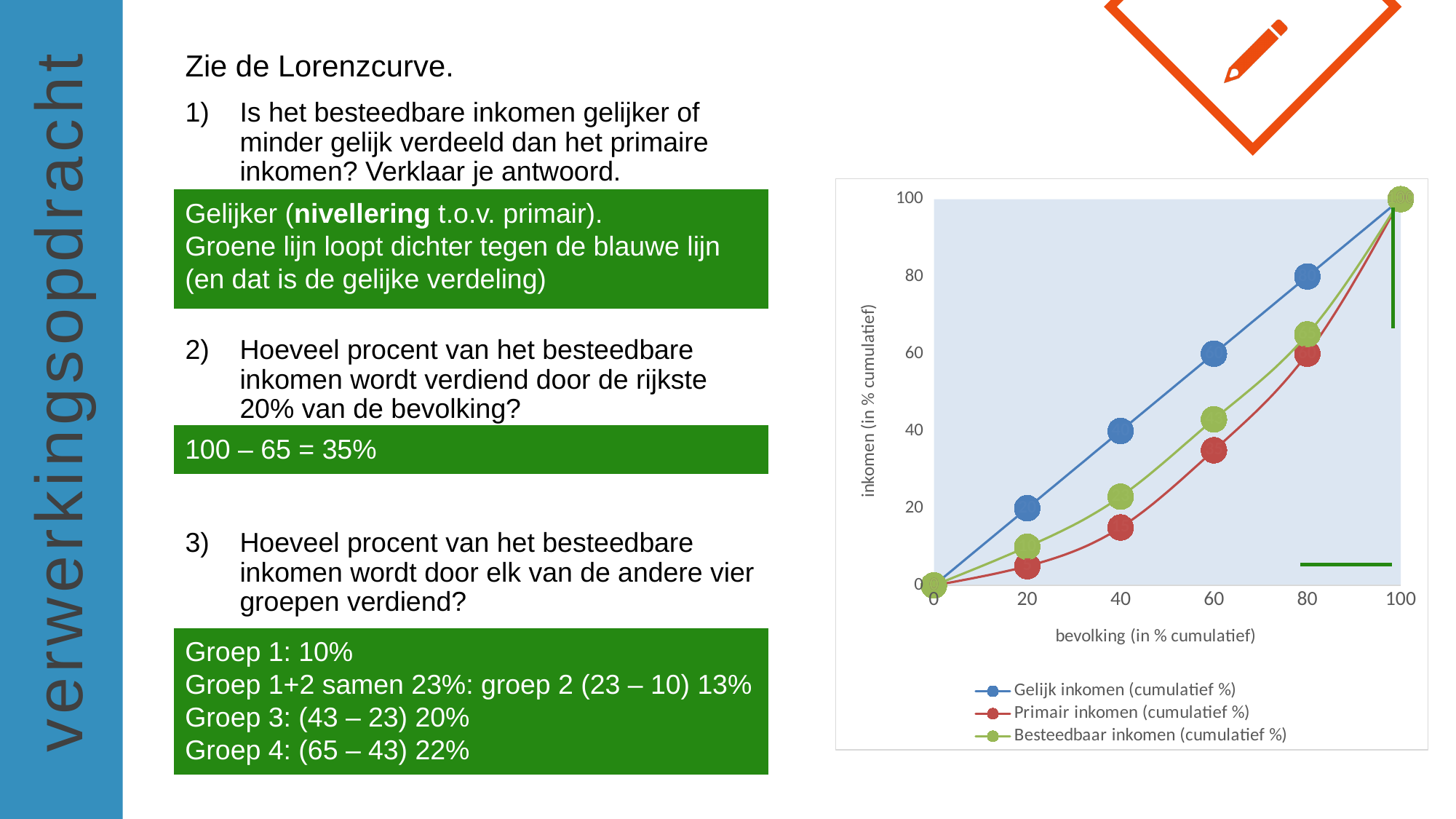
How many series does the chart legend list? 3 Is the value for Besteedbaar inkomen at 80% of the bevolking greater or less than 60? greater At 40% of the bevolking, which is larger: Besteedbaar inkomen or Primair inkomen? Besteedbaar inkomen Is the value for Primair inkomen at 60% of the bevolking greater or less than 40? less What is the value of Gelijk inkomen (cumulatief %) at 80% of the bevolking? 80 How many data points does the Gelijk inkomen series have? 6 What kind of chart is shown on the slide? line chart What is the title of the x axis of the chart? bevolking (in % cumulatief) What is the value of Gelijk inkomen (cumulatief %) at 60% of the bevolking? 60 Is the value for Besteedbaar inkomen at 40% of the bevolking greater or less than 40? less Which series has the lowest value at 80% of the bevolking? Primair inkomen (cumulatief %) Do the values of the Primair inkomen series rise or fall along the x axis? rise